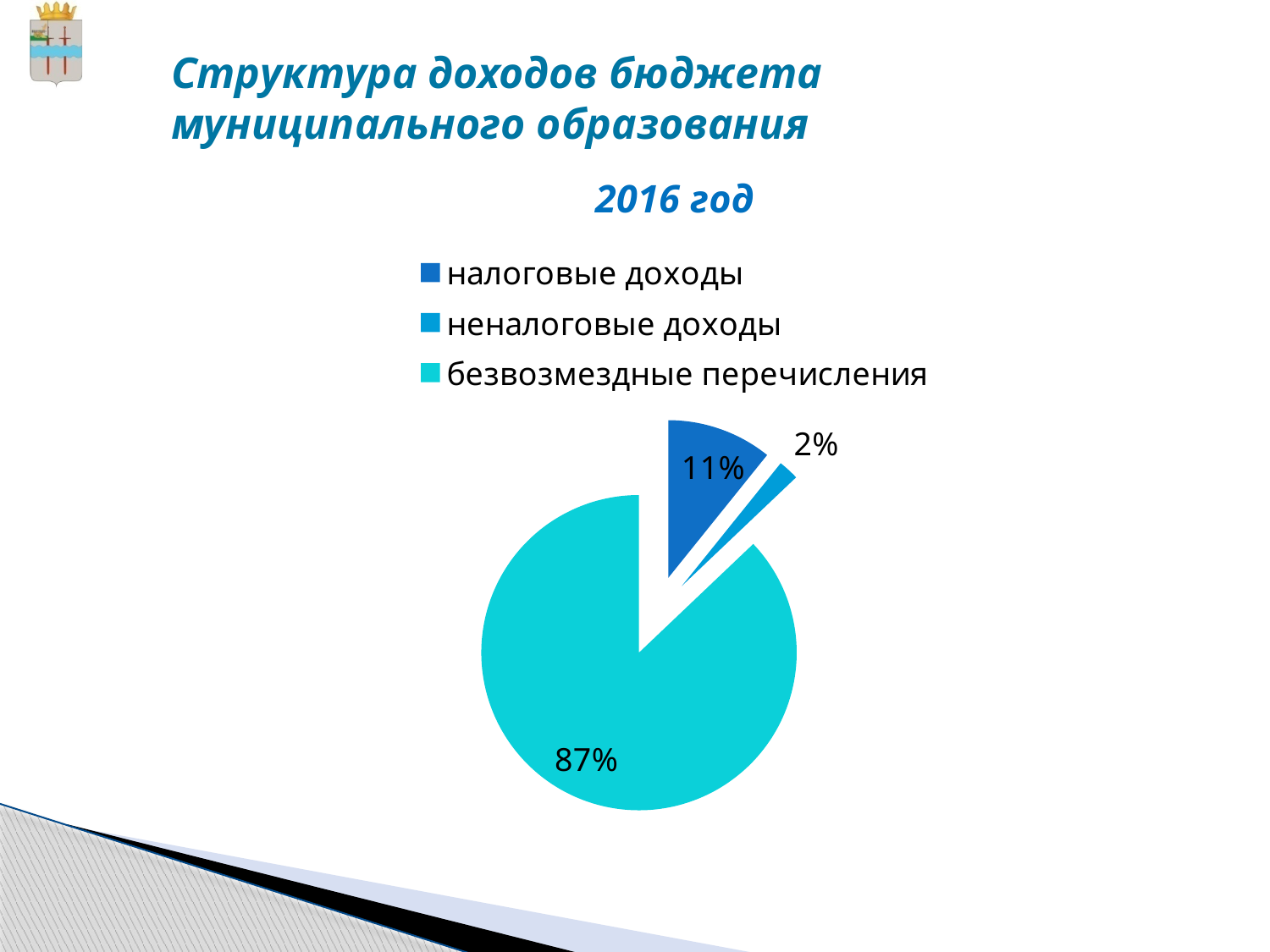
What kind of chart is shown on the slide? pie chart How many entries does the legend list? 3 What share of the pie does безвозмездные перечисления have? 87% What share of the pie does налоговые доходы have? 11% What share of the pie does неналоговые доходы have? 2% Which category has the largest slice of the pie? безвозмездные перечисления Which is larger, the share for налоговые доходы or the share for неналоговые доходы? налоговые доходы How many slices does the pie chart have? 3 What year is shown as the chart title? 2016 год Which category has the smallest slice of the pie? неналоговые доходы What is the difference in percentage points between налоговые доходы and неналоговые доходы? 9 What is the difference in percentage points between безвозмездные перечисления and налоговые доходы? 76